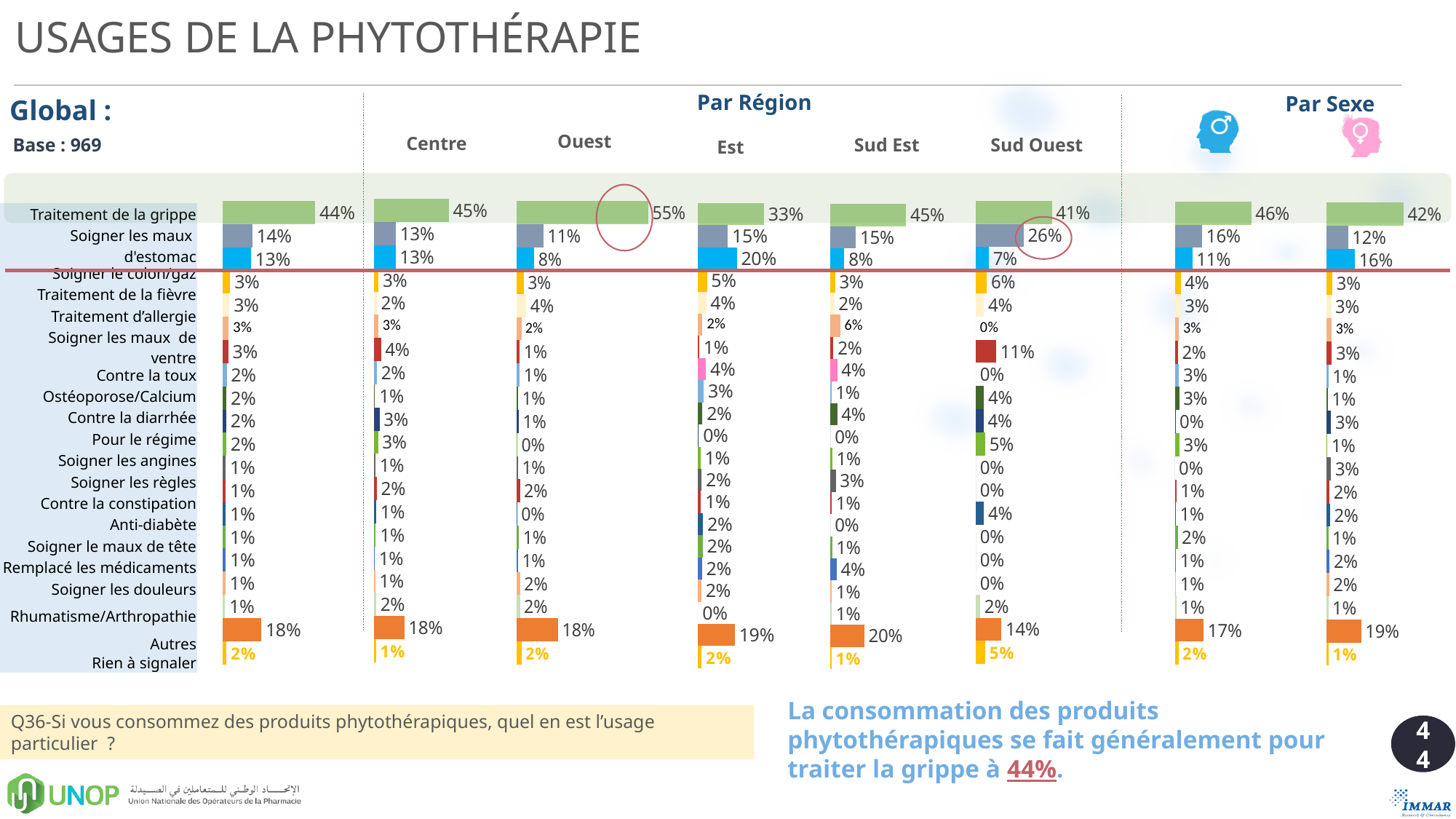
What type of chart is used to display the data on this slide? Bar chart Among the five regional charts, which region has the lowest value for Traitement de la grippe? Est Comparing the Par Sexe charts, is the Traitement de la grippe value higher for men or for women? Men (46% vs 42%) In the Global chart, what percentage is shown for Traitement de la grippe? 44% What is the base (sample size) stated for the Global chart? 969 In the Sud Ouest chart, what percentage is shown for Soigner les maux d'estomac? 26% What is the difference in percentage points between the Traitement de la grippe value in the Ouest chart and in the Est chart? 22 percentage points In the Global chart, what percentage is shown for Autres? 18% In the Sud Est chart, what percentage is shown for Autres? 20% Among the five regional charts, which region has the highest value for Rien à signaler? Sud Ouest Among the five regional charts (Centre, Ouest, Est, Sud Est, Sud Ouest), which region has the highest value for Traitement de la grippe? Ouest In the Ouest chart, what percentage is shown for Traitement de la grippe? 55%